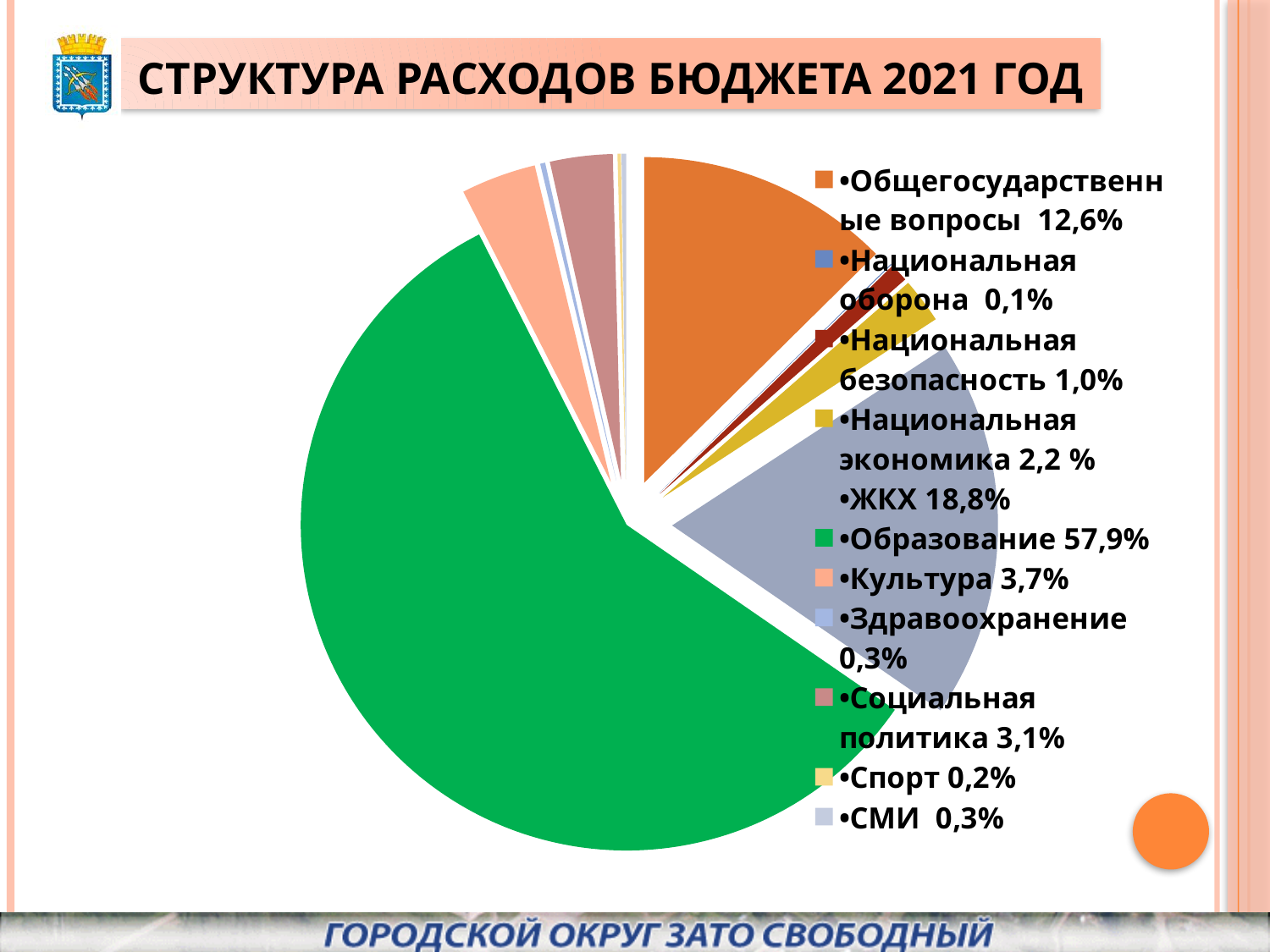
What share of the budget expenditure goes to ЖКХ? 18,8% What share of the budget expenditure goes to Образование? 57,9% What share of the budget expenditure goes to Социальная политика? 3,1% What share of the budget expenditure goes to Общегосударственные вопросы? 12,6% What is the difference in percentage points between the shares of Образование and ЖКХ? 39,1 What is the title of the chart on the slide? СТРУКТУРА РАСХОДОВ БЮДЖЕТА 2021 ГОД Which has a larger share of the budget expenditure, ЖКХ or Общегосударственные вопросы? ЖКХ What kind of chart is shown on the slide? Pie chart Which category has the smallest share of the budget expenditure? Национальная оборона How many categories does the legend of the pie chart list? 11 Which category has the largest share of the budget expenditure? Образование What share of the budget expenditure goes to Культура? 3,7%